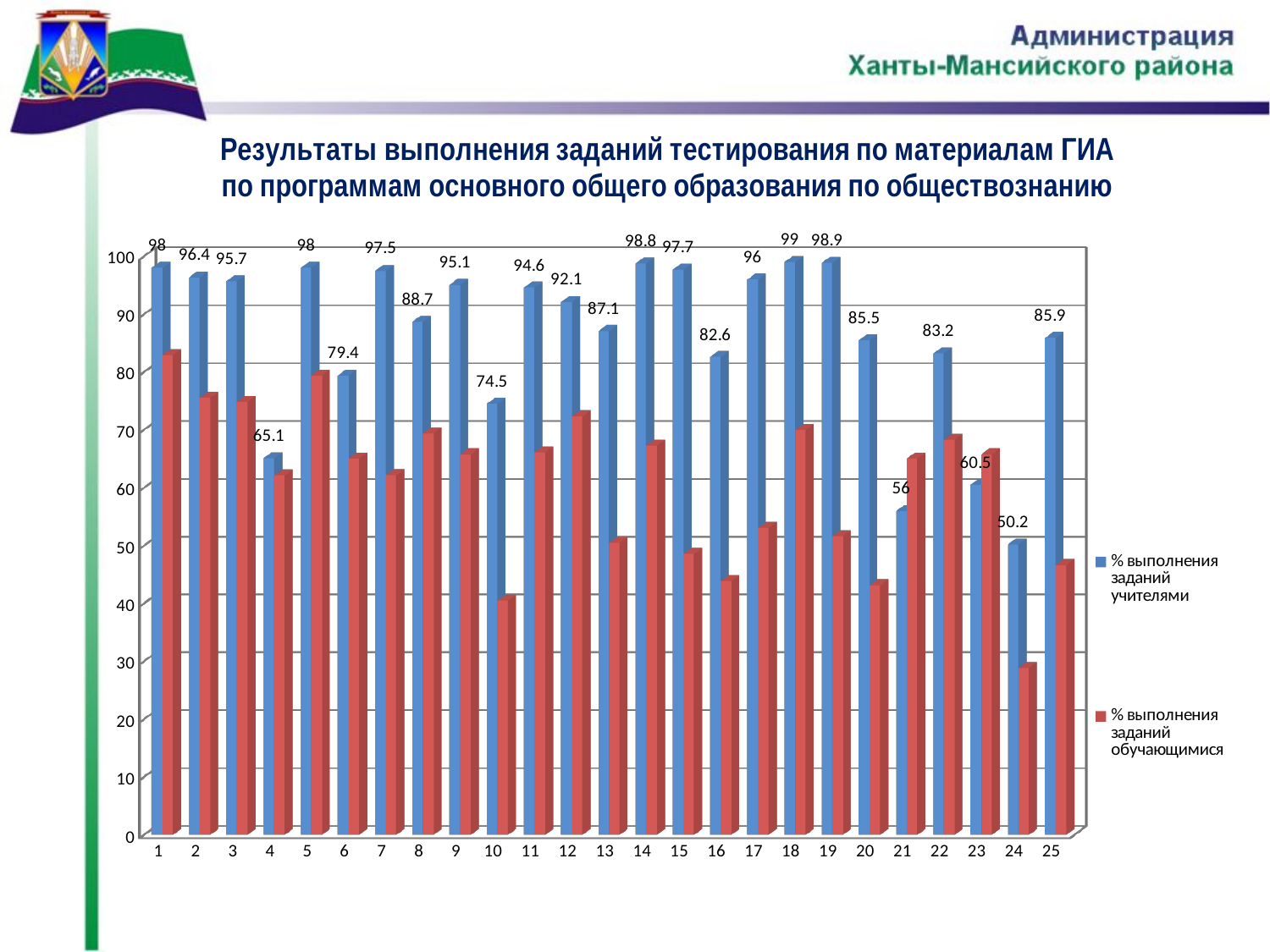
What is the value of "% выполнения заданий учителями" for category 18? 99 How many categories are shown on the x axis? 25 What is the value of "% выполнения заданий учителями" for category 21? 56 What type of chart is shown on the slide? bar chart What is the value of "% выполнения заданий учителями" for category 10? 74.5 Is the value of "% выполнения заданий обучающимися" for category 1 greater or less than 80? greater Which category has the highest value for "% выполнения заданий учителями"? 18 How many series does the legend list? 2 What is the difference between the "% выполнения заданий учителями" values for category 1 and category 4? 32.9 Is the value of "% выполнения заданий обучающимися" for category 24 greater or less than 40? less Which is larger for "% выполнения заданий учителями": category 13 or category 20? category 13 Which category has the lowest value for "% выполнения заданий учителями"? 24